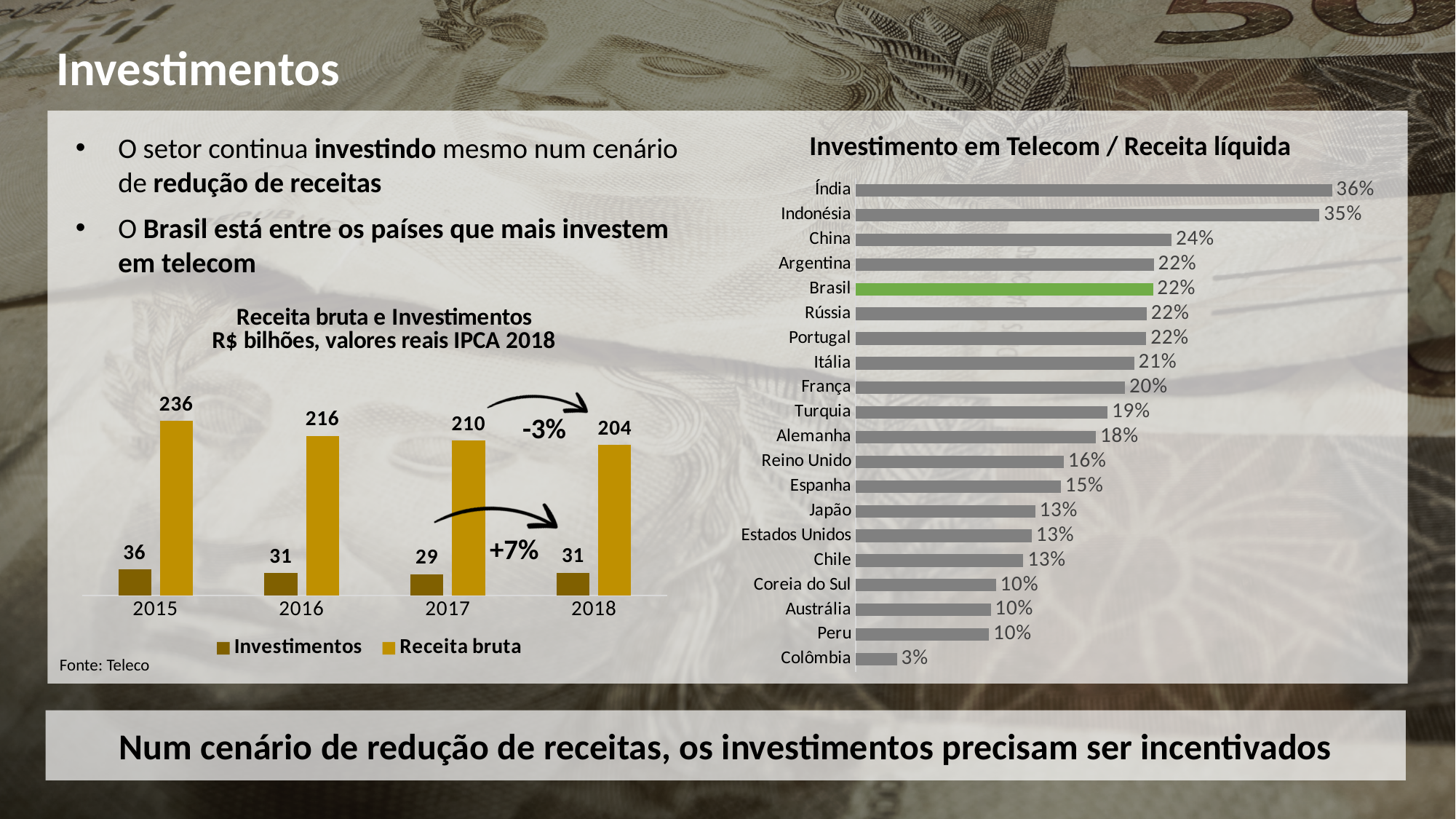
In the 'Receita bruta e Investimentos' chart, does Receita bruta rise or fall from 2015 to 2018? fall In the 'Investimento em Telecom / Receita líquida' chart, how many countries are shown? 20 What kind of chart is the 'Investimento em Telecom / Receita líquida' chart? bar chart In the 'Receita bruta e Investimentos' chart, which year has the lowest Receita bruta? 2018 In the 'Receita bruta e Investimentos' chart, how many series does the legend list? 2 In the 'Investimento em Telecom / Receita líquida' chart, which is larger, the value for China or the value for Alemanha? China In the 'Receita bruta e Investimentos' chart, what is the difference between Receita bruta in 2015 and 2018? 32 In the 'Investimento em Telecom / Receita líquida' chart, which country has the lowest value? Colômbia In the 'Investimento em Telecom / Receita líquida' chart, what is the value for Brasil? 22% In the 'Investimento em Telecom / Receita líquida' chart, which country has the highest value? Índia In the 'Receita bruta e Investimentos' chart, what is the Investimentos value for 2017? 29 In the 'Receita bruta e Investimentos' chart, what is the Receita bruta value for 2015? 236